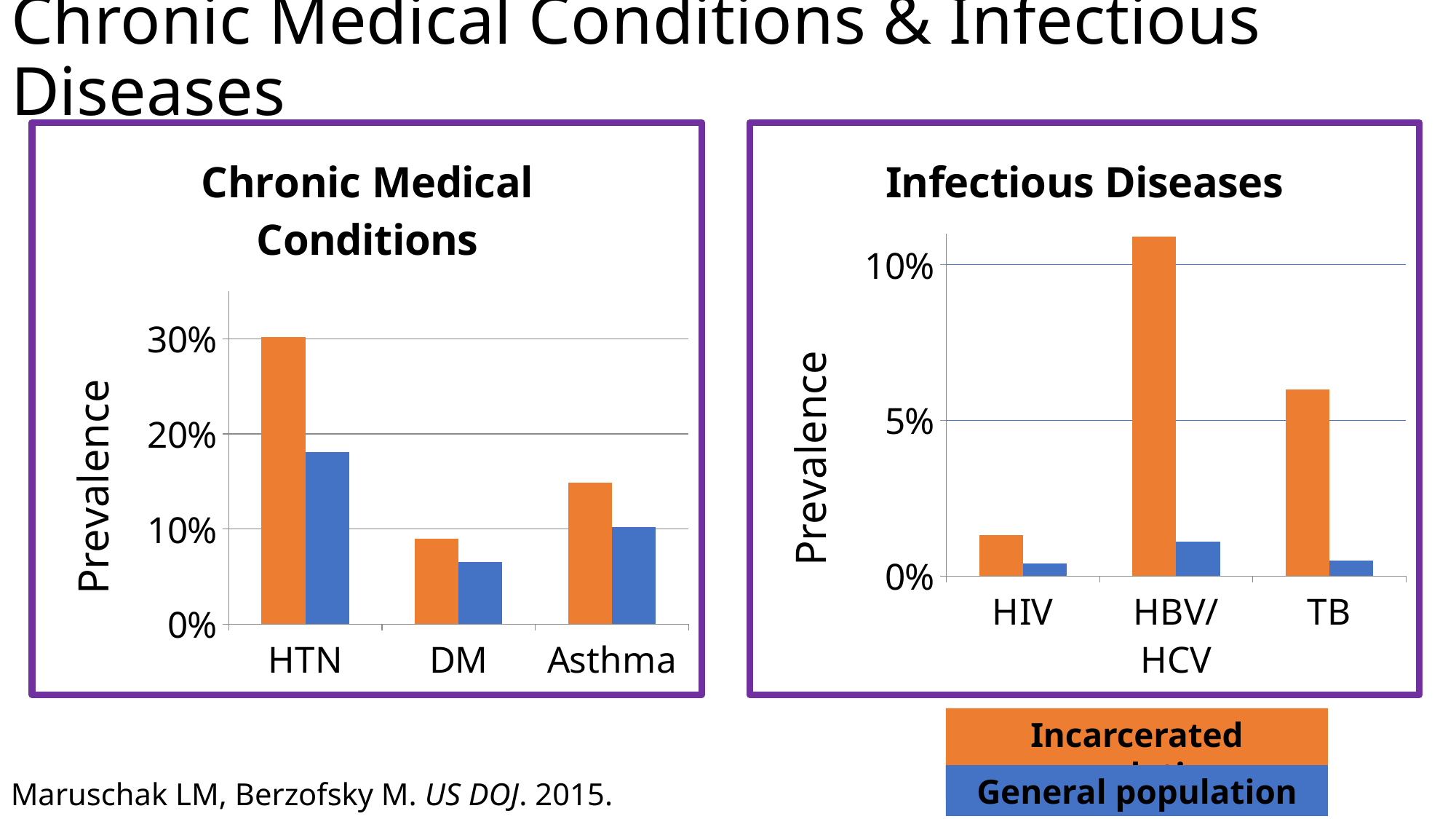
What is the y-axis label on the "Infectious Diseases" chart? Prevalence What kind of chart is the "Chronic Medical Conditions" chart? bar chart In the "Infectious Diseases" chart, which category has the highest Incarcerated value? HBV/HCV In the "Chronic Medical Conditions" chart, which category has the lowest Incarcerated value? DM How many categories are shown on the x axis of the "Infectious Diseases" chart? 3 In the "Chronic Medical Conditions" chart, which category has the highest Incarcerated value? HTN How many series does the legend list? 2 In the "Chronic Medical Conditions" chart, is the General population value for HTN greater or less than 20%? less In the "Infectious Diseases" chart, is the Incarcerated value for HBV/HCV greater or less than 10%? greater In the "Infectious Diseases" chart, which category has the lowest Incarcerated value? HIV How many categories are shown on the x axis of the "Chronic Medical Conditions" chart? 3 In the "Chronic Medical Conditions" chart, which is larger: the Incarcerated value for Asthma or the Incarcerated value for DM? Asthma